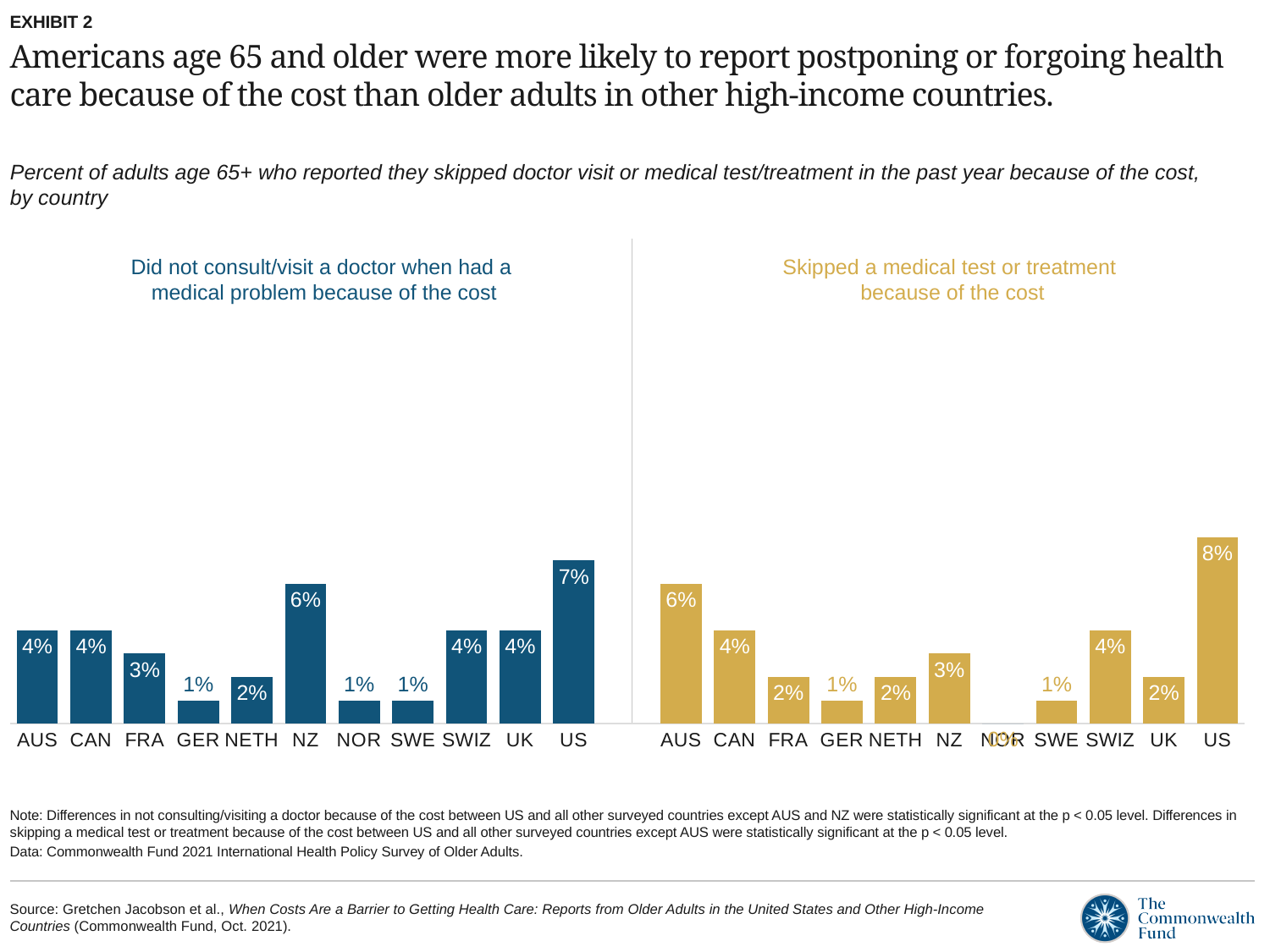
In the chart 'Did not consult/visit a doctor when had a medical problem because of the cost', which is larger, the value for FRA or the value for NETH? FRA What type of chart is used on the left side of the slide? Bar chart In the chart 'Skipped a medical test or treatment because of the cost', which is larger, the value for CAN or the value for NZ? CAN In the chart 'Did not consult/visit a doctor when had a medical problem because of the cost', what is the value for NZ? 6% In the chart 'Did not consult/visit a doctor when had a medical problem because of the cost', which country has the highest value? US In the chart 'Did not consult/visit a doctor when had a medical problem because of the cost', what is the difference between the US and NZ values? 1% In the chart 'Skipped a medical test or treatment because of the cost', what is the value for AUS? 6% In the chart 'Skipped a medical test or treatment because of the cost', what is the value for the US? 8% In the chart 'Did not consult/visit a doctor when had a medical problem because of the cost', what is the value for the US? 7% How many countries are shown in the chart 'Did not consult/visit a doctor when had a medical problem because of the cost'? 11 In the chart 'Skipped a medical test or treatment because of the cost', which country has the highest value? US In the chart 'Skipped a medical test or treatment because of the cost', what is the difference between the US and AUS values? 2%